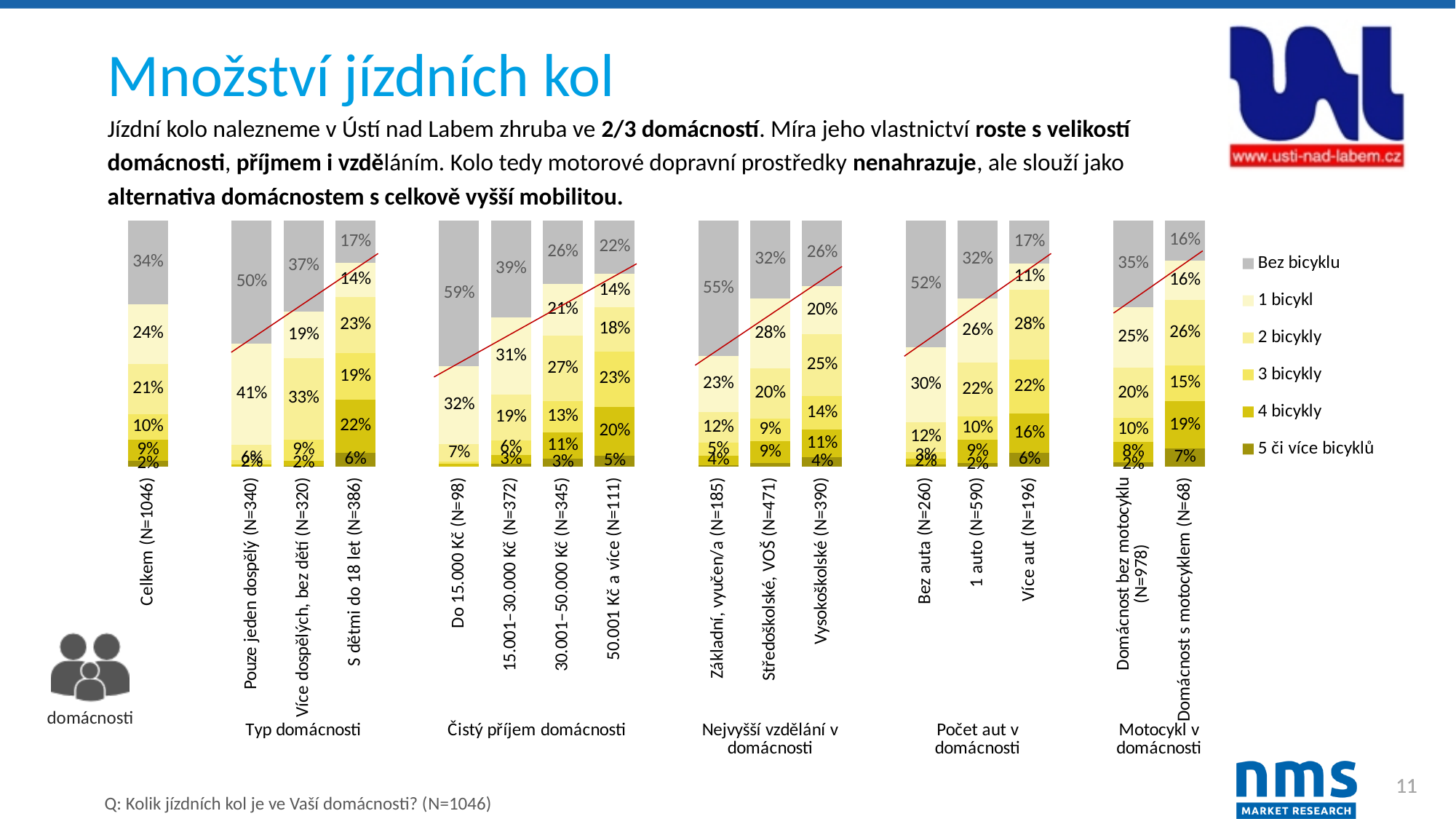
How many series does the legend list? 6 What kind of chart is used on this slide? Stacked bar chart In the Celkem (N=1046) bar, what share of households have no bicycle (Bez bicyklu)? 34% In the Typ domácnosti chart, which has the larger 1 bicykl share: Pouze jeden dospělý (N=340) or Více dospělých, bez dětí (N=320)? Pouze jeden dospělý (N=340) In the Čistý příjem domácnosti chart, what is the Bez bicyklu share for Do 15.000 Kč (N=98)? 59% Which legend entry is shown in grey? Bez bicyklu In the Počet aut v domácnosti chart, which category has the highest Bez bicyklu share? Bez auta (N=260) In the Čistý příjem domácnosti chart, which income category has the lowest Bez bicyklu share? 50.001 Kč a více (N=111) In the Motocykl v domácnosti chart, what is the difference in the Bez bicyklu share between Domácnost bez motocyklu (N=978) and Domácnost s motocyklem (N=68)? 19 percentage points In the Počet aut v domácnosti chart, what is the 4 bicykly share for Více aut (N=196)? 16% In the Nejvyšší vzdělání v domácnosti chart, what is the 2 bicykly share for Vysokoškolské (N=390)? 25% In the Typ domácnosti chart, what is the Bez bicyklu share for S dětmi do 18 let (N=386)? 17%